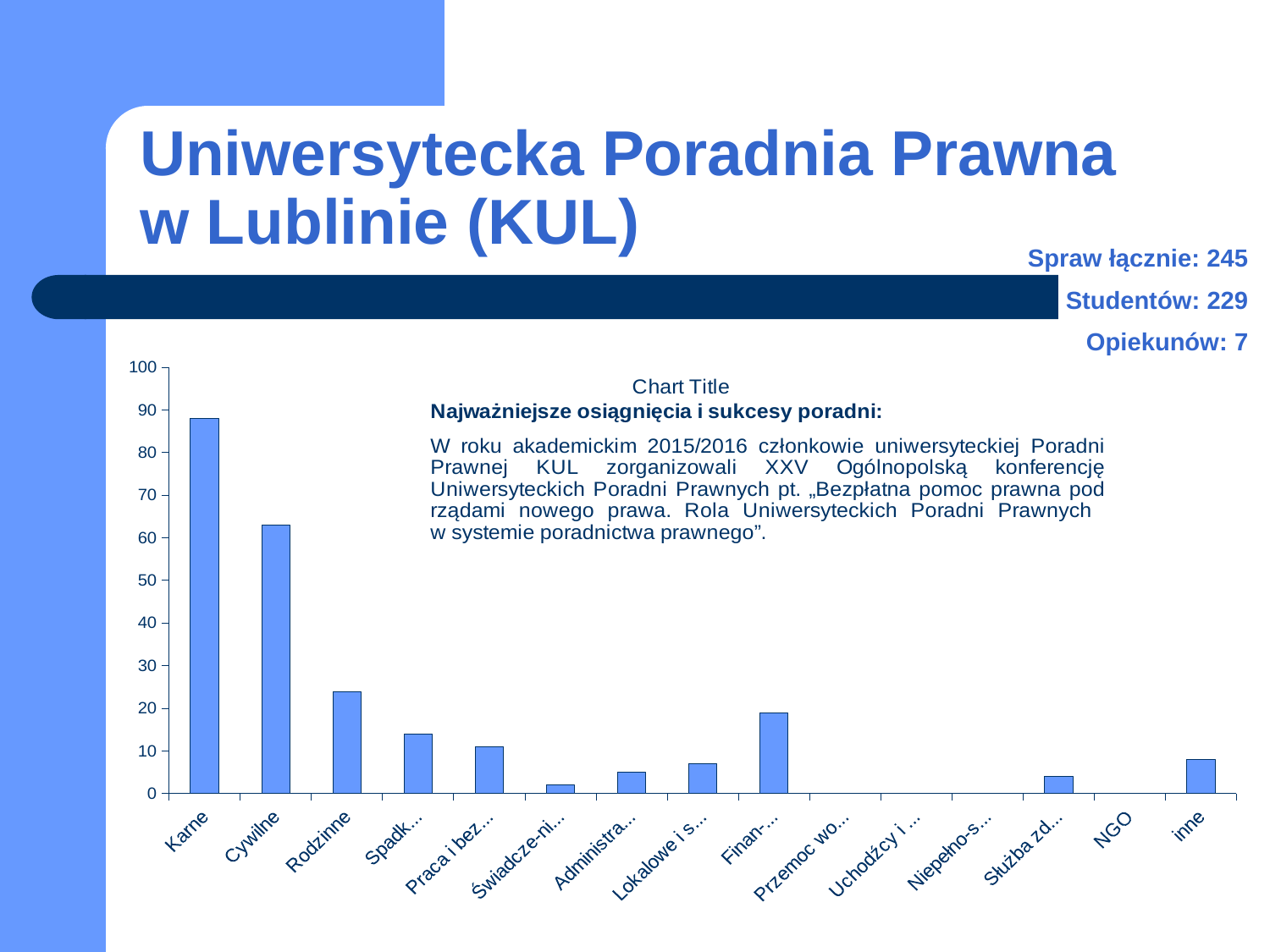
Is the value for inne greater or less than 10? less How many categories are shown on the x axis of the chart? 15 Which category has the highest value in the chart? Karne Which is larger, the value for Cywilne or the value for Rodzinne? Cywilne Is the value for Cywilne greater or less than 60? greater Is the value for NGO greater or less than 10? less Which is larger, the value for Rodzinne or the value for inne? Rodzinne What kind of chart is shown on the slide? bar chart Which is larger, the value for Karne or the value for Cywilne? Karne What title is displayed above the chart? Chart Title